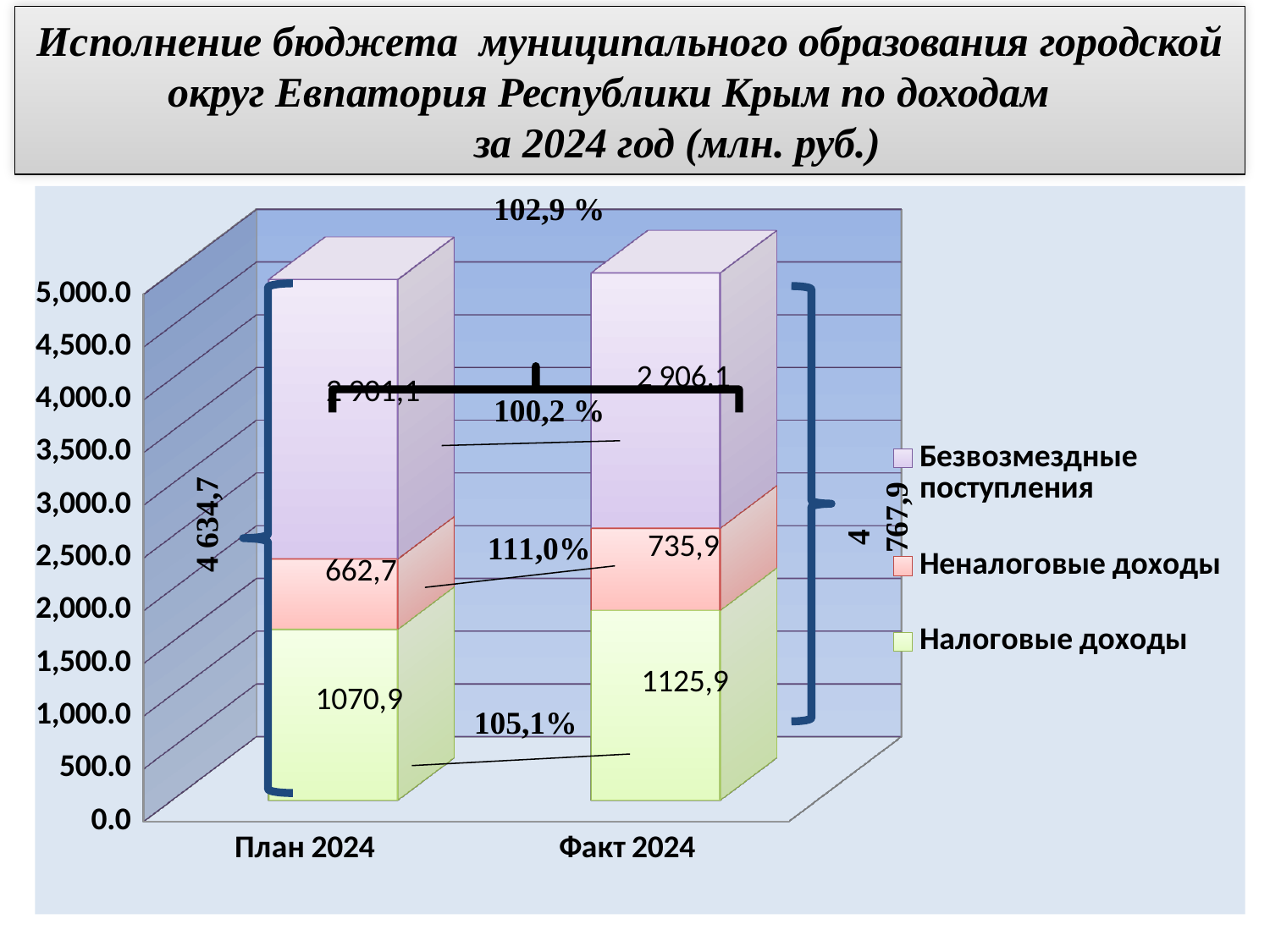
How many series does the legend list? 3 Which is larger, Неналоговые доходы for План 2024 or for Факт 2024? Факт 2024 What is the total of the stacked bar for План 2024? 4 634,7 What is the value of Неналоговые доходы for Факт 2024? 735,9 What is the total of the stacked bar for Факт 2024? 4 767,9 What percentage is shown above the chart for the overall execution of the budget? 102,9 % How many categories are shown on the x axis? 2 What is the value of Неналоговые доходы for План 2024? 662,7 What is the value of Безвозмездные поступления for Факт 2024? 2 906,1 What type of chart is shown on the slide? Stacked bar chart What is the value of Налоговые доходы for План 2024? 1070,9 What is the value of Налоговые доходы for Факт 2024? 1125,9